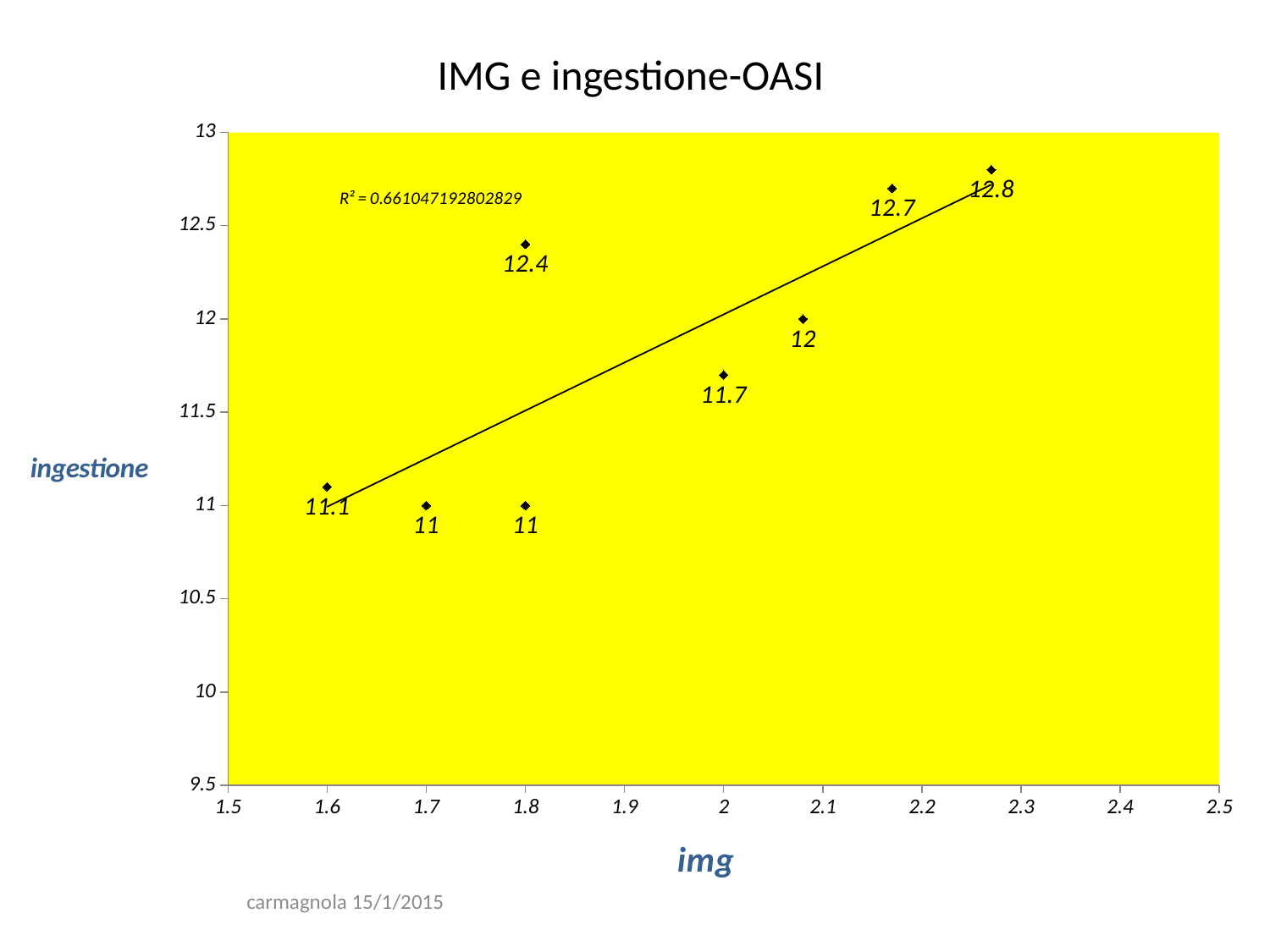
How many data points are plotted on the chart? 8 What is the difference between the highest labelled value (12.8) and the value at img 1.6 (11.1)? 1.7 What is the ingestione value of the point at img 1.6? 11.1 What is the difference between the points labelled 12.7 and 12.4? 0.3 What is the lowest ingestione value labelled on the chart? 11 What is the ingestione value of the point at img 1.7? 11 What is the title of the chart? IMG e ingestione-OASI What kind of chart is shown on the slide? scatter chart Which has the larger ingestione value: the point at img 1.6 or the point at img 1.7? img 1.6 Do the ingestione values generally rise or fall as img increases along the x axis? rise What is the highest ingestione value labelled on the chart? 12.8 What R² value is printed on the chart? 0.661047192802829